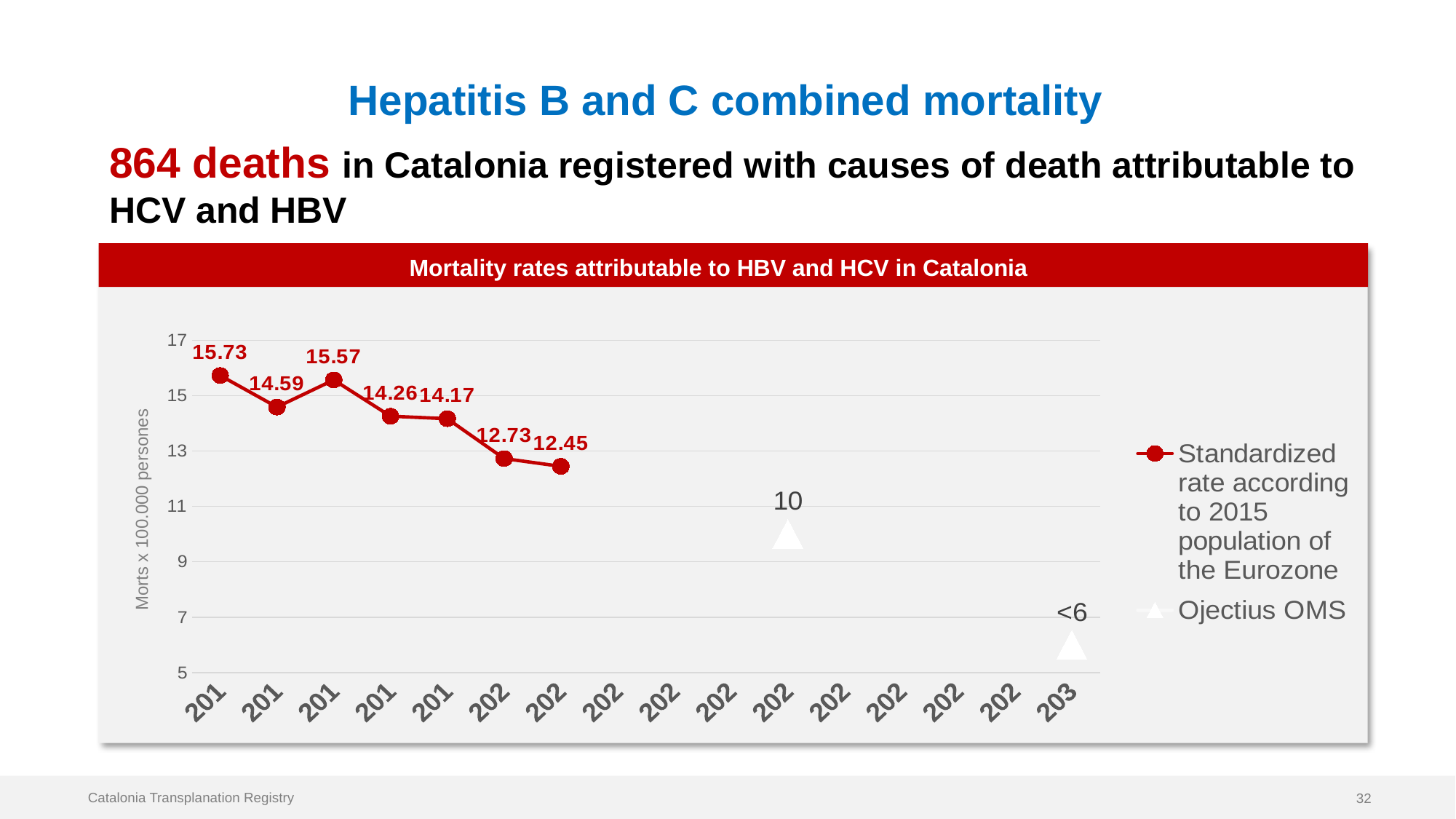
How many series does the chart legend list? 2 What is the lowest value labelled on the red 'Standardized rate' line? 12.45 How many data points are plotted on the red 'Standardized rate' line? 7 What is the highest value labelled on the red 'Standardized rate' line? 15.73 What is the value of the second point on the red 'Standardized rate' line? 14.59 What value is labelled on the second 'Ojectius OMS' triangle marker? <6 What is the value of the first point on the red 'Standardized rate' line? 15.73 Overall, do the values on the red 'Standardized rate' line rise or fall along the x axis? fall What is the difference between the first (15.73) and last (12.45) values on the red line? 3.28 What is the title of the chart? Mortality rates attributable to HBV and HCV in Catalonia What kind of chart is shown on the slide? line chart Which is larger on the red line: the second point (14.59) or the third point (15.57)? the third point (15.57)